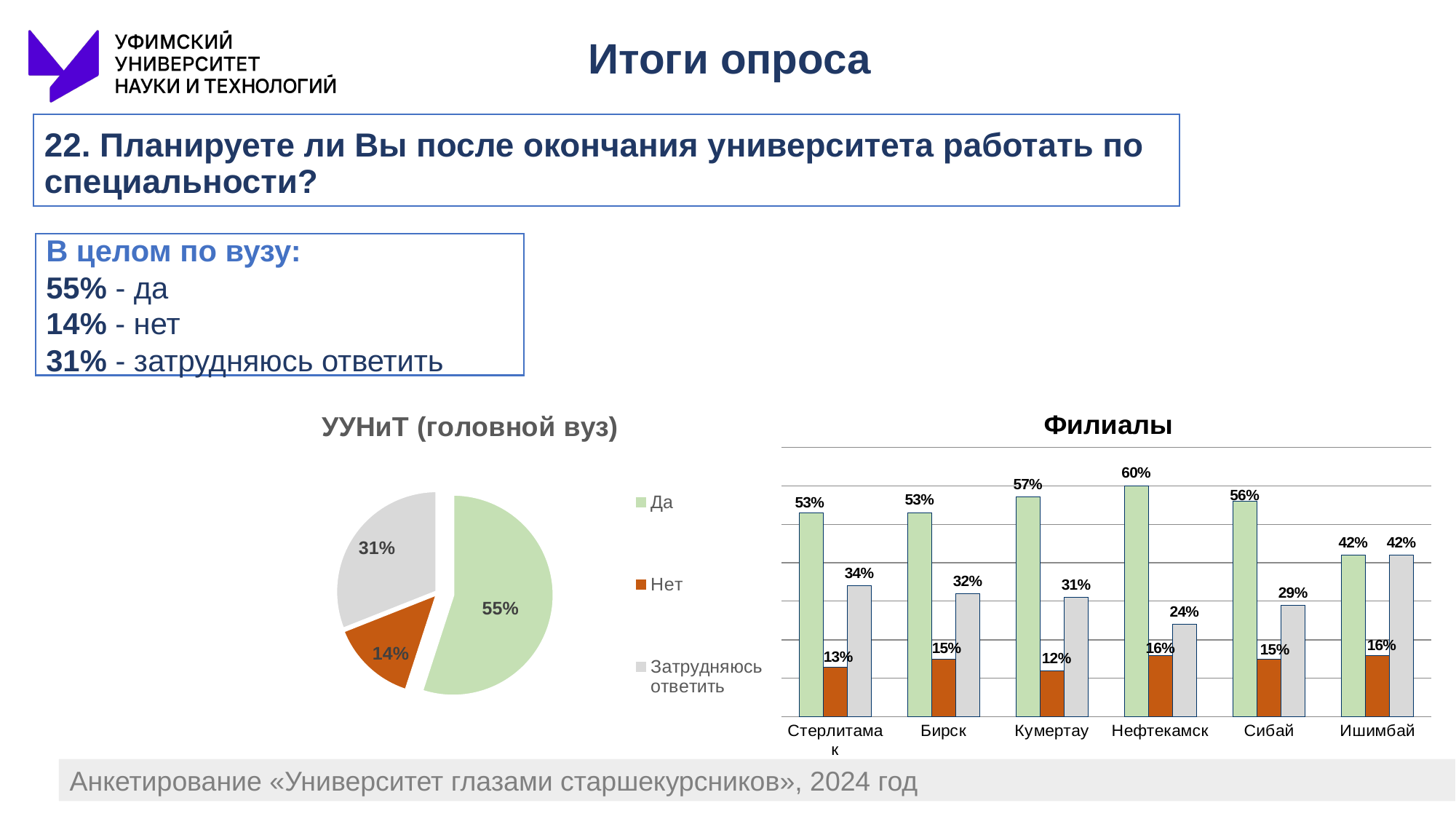
How many branches are shown on the x axis of the chart titled «Филиалы»? 6 In the chart titled «Филиалы», which branch has the lowest value for «Да»? Ишимбай In the pie chart titled «УУНиТ (головной вуз)», what share of respondents answered «Да»? 55% What kind of chart is the chart titled «Филиалы»? Bar chart In the pie chart titled «УУНиТ (головной вуз)», what share of respondents answered «Нет»? 14% In the pie chart titled «УУНиТ (головной вуз)», how many entries does the legend list? 3 In the chart titled «Филиалы», what is the value of «Да» for Нефтекамск? 60% In the chart titled «Филиалы», which is larger: the «Нет» value for Кумертау or for Нефтекамск? Нефтекамск In the chart titled «Филиалы», what is the difference between the «Да» values for Нефтекамск and Ишимбай? 18% In the chart titled «Филиалы», what is the value of «Затрудняюсь ответить» for Стерлитамак? 34% In the chart titled «Филиалы», which branch has the highest value for «Да»? Нефтекамск In the pie chart titled «УУНиТ (головной вуз)», which answer has the largest slice? Да